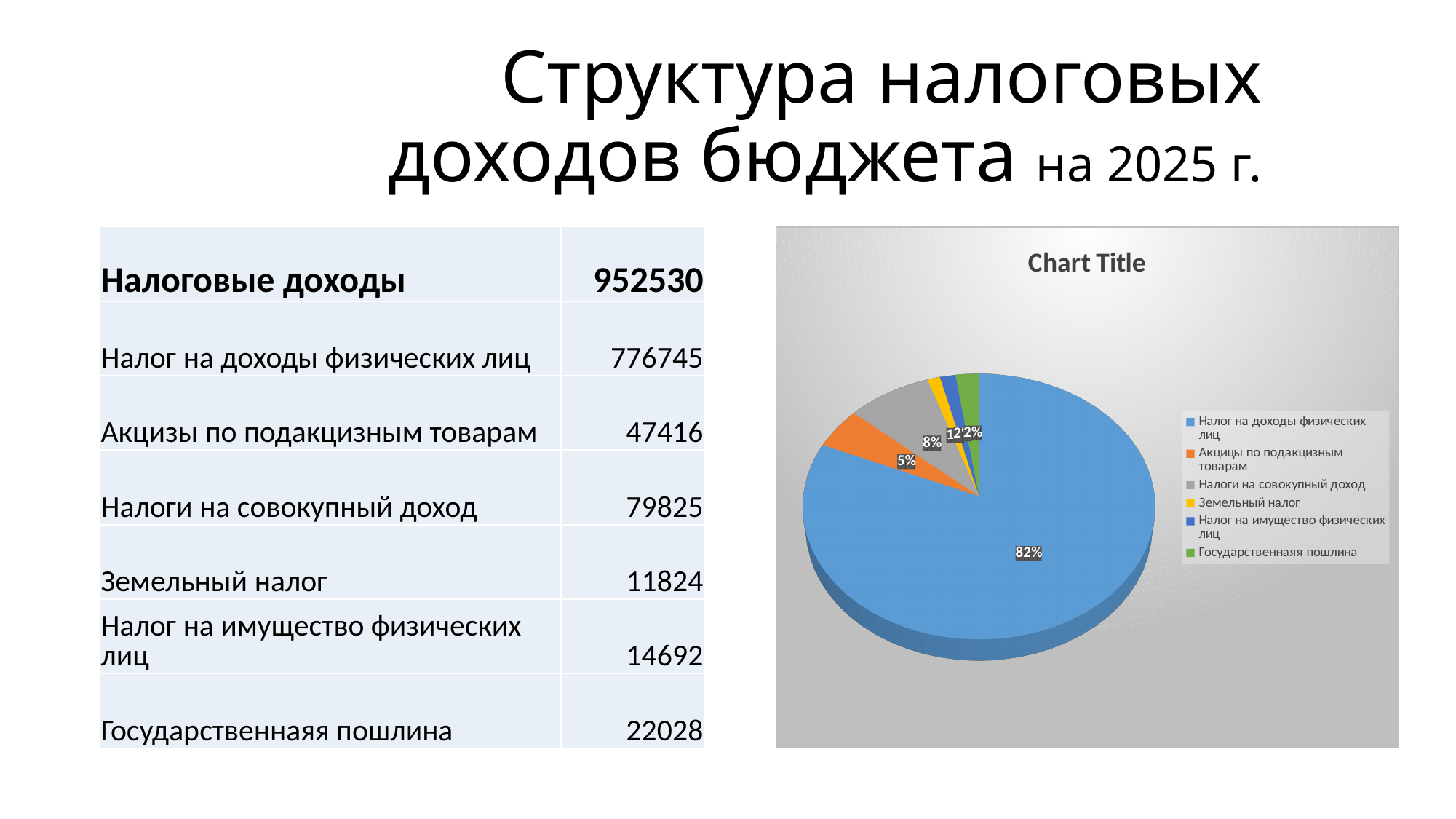
What kind of chart is shown on the slide? pie chart What is the title shown on the pie chart? Chart Title Which slice is larger: Акцицы по подакцизным товарам or Земельный налог? Акцицы по подакцизным товарам What share of the pie does Акцицы по подакцизным товарам have? 5% Which slice is larger: Налоги на совокупный доход or Акцицы по подакцизным товарам? Налоги на совокупный доход What share of the pie does Налог на доходы физических лиц have? 82% What is the difference in percentage points between the share of Налог на доходы физических лиц and the share of Налоги на совокупный доход? 74% What colour is the slice for Налог на доходы физических лиц? blue What share of the pie does Налоги на совокупный доход have? 8% Which category has the largest slice of the pie? Налог на доходы физических лиц How many categories does the pie chart's legend list? 6 What is the difference in percentage points between the share of Налоги на совокупный доход and the share of Акцицы по подакцизным товарам? 3%